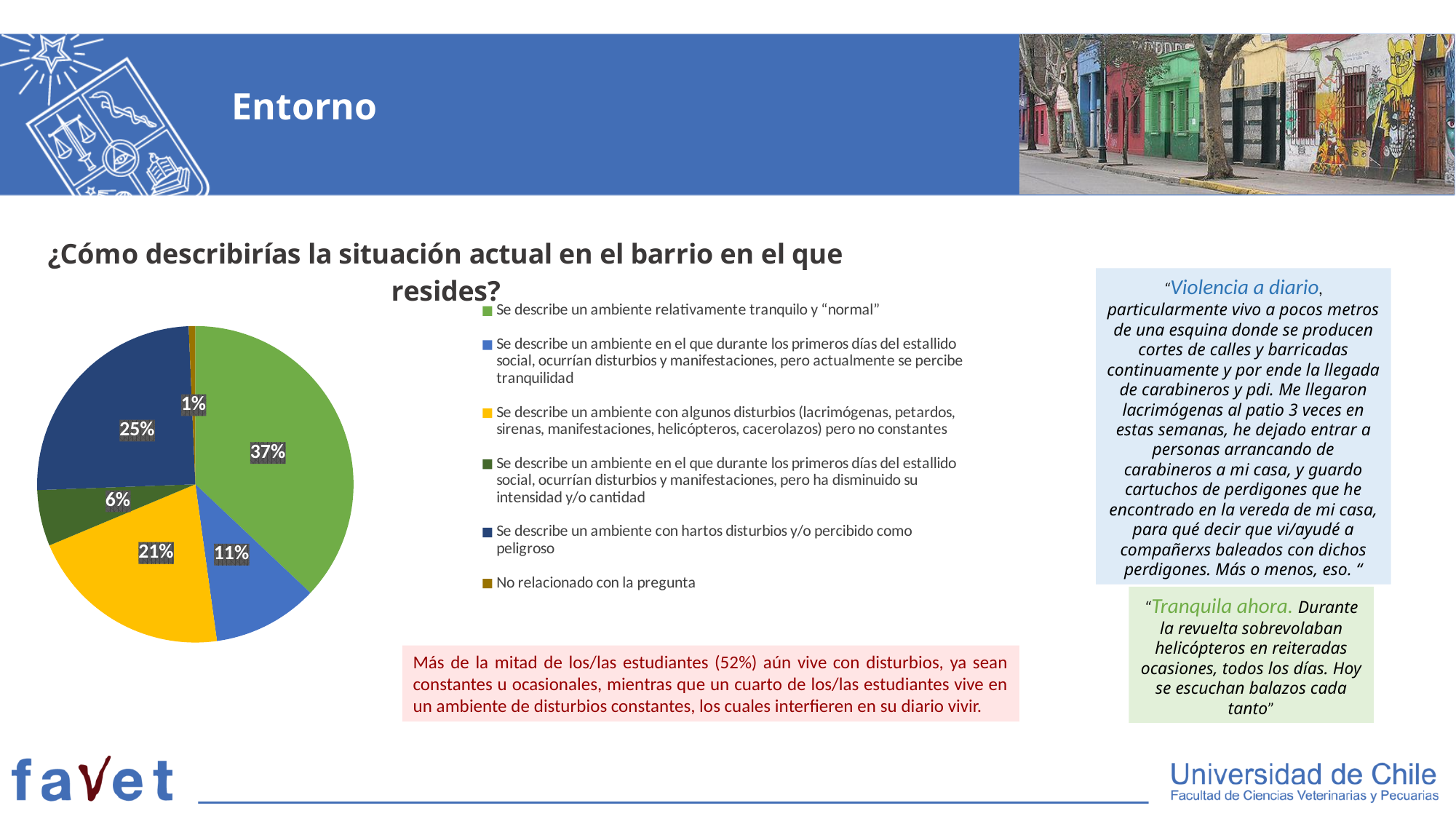
What is the difference in percentage points between the largest slice (37%) and the slice for "hartos disturbios y/o percibido como peligroso" (25%)? 12 What kind of chart is shown on the slide? pie chart What share of the pie corresponds to "Se describe un ambiente relativamente tranquilo y "normal""? 37% What colour is the slice for "Se describe un ambiente con hartos disturbios y/o percibido como peligroso"? dark blue How many categories does the pie chart have? 6 Which is larger: the slice for "algunos disturbios ... pero no constantes" or the slice for "durante los primeros días del estallido social ... pero actualmente se percibe tranquilidad"? algunos disturbios ... pero no constantes What share of the pie corresponds to "Se describe un ambiente con algunos disturbios (lacrimógenas, petardos, sirenas, manifestaciones, helicópteros, cacerolazos) pero no constantes"? 21% Which category has the smallest slice of the pie? No relacionado con la pregunta Which category has the largest slice of the pie? Se describe un ambiente relativamente tranquilo y "normal" What share of the pie corresponds to the category describing an environment where disturbances have diminished in intensity and/or quantity? 6%